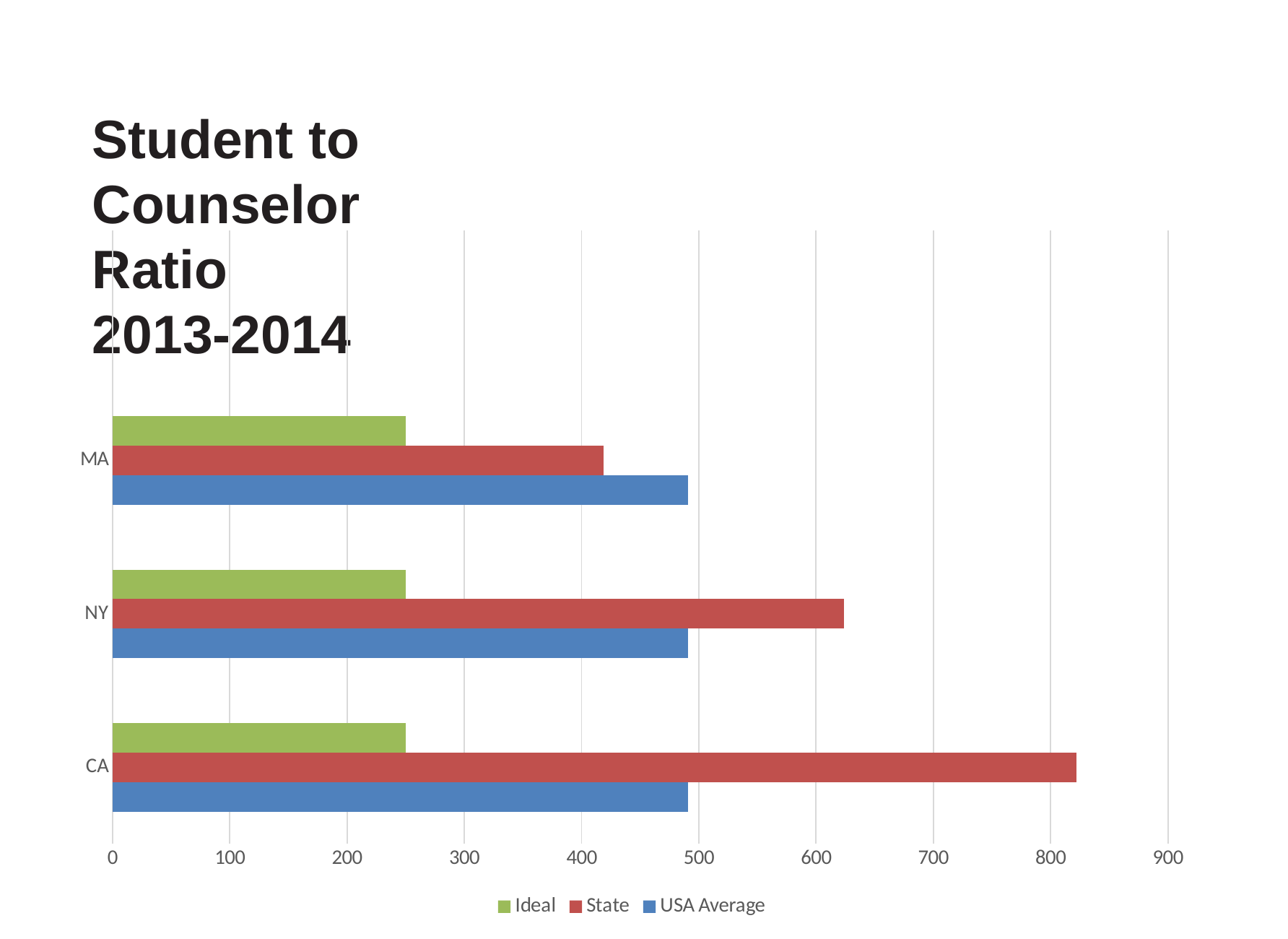
Which is larger for MA, the State value or the USA Average value? USA Average What is the title of the chart? Student to Counselor Ratio 2013-2014 What kind of chart is shown on the slide? bar chart Which series is shown in red? State Is the State value for CA greater or less than 800? greater Is the State value for MA greater or less than 500? less Is the State value for NY greater or less than 600? greater Which state has the highest State student-to-counselor ratio? CA Which state has the lowest State student-to-counselor ratio? MA How many states (categories) are shown on the chart? 3 How many series does the legend list? 3